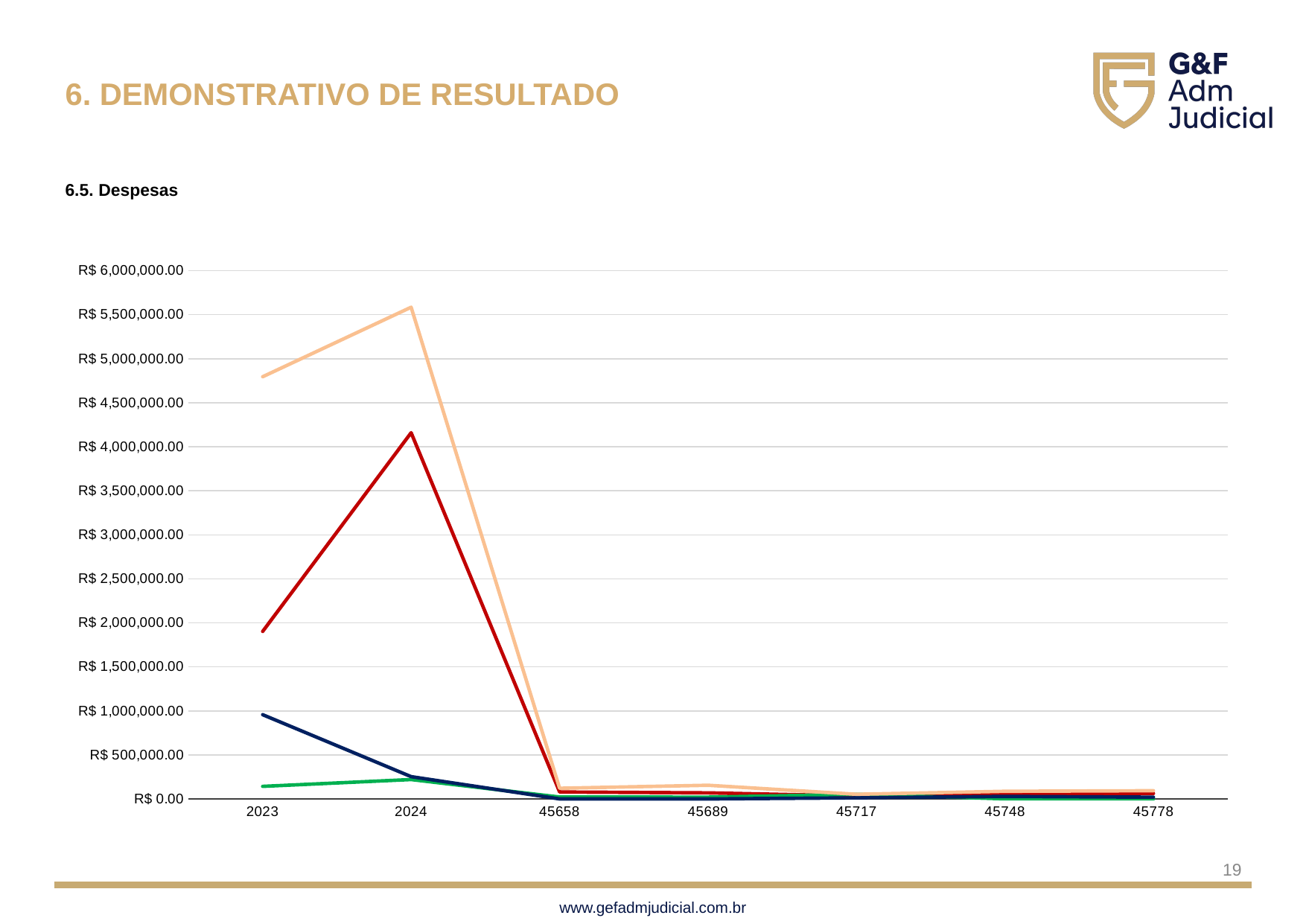
How many points are labelled along the x axis of the chart? 7 Is the value of the dark blue line at 2023 greater or less than R$ 1,500,000.00? less What is the highest value labelled on the y axis of the chart? R$ 6,000,000.00 Is the value of the red line at 2023 greater or less than R$ 1,500,000.00? greater At which x-axis point does the light orange line reach its highest value? 2024 At 2023, which line has the larger value: the light orange line or the red line? the light orange line Is the value of the red line at 2024 greater or less than R$ 3,500,000.00? greater Does the light orange line rise or fall between 2024 and 45658? fall At 2023, which line has the larger value: the dark blue line or the green line? the dark blue line What kind of chart is shown on the slide? line chart